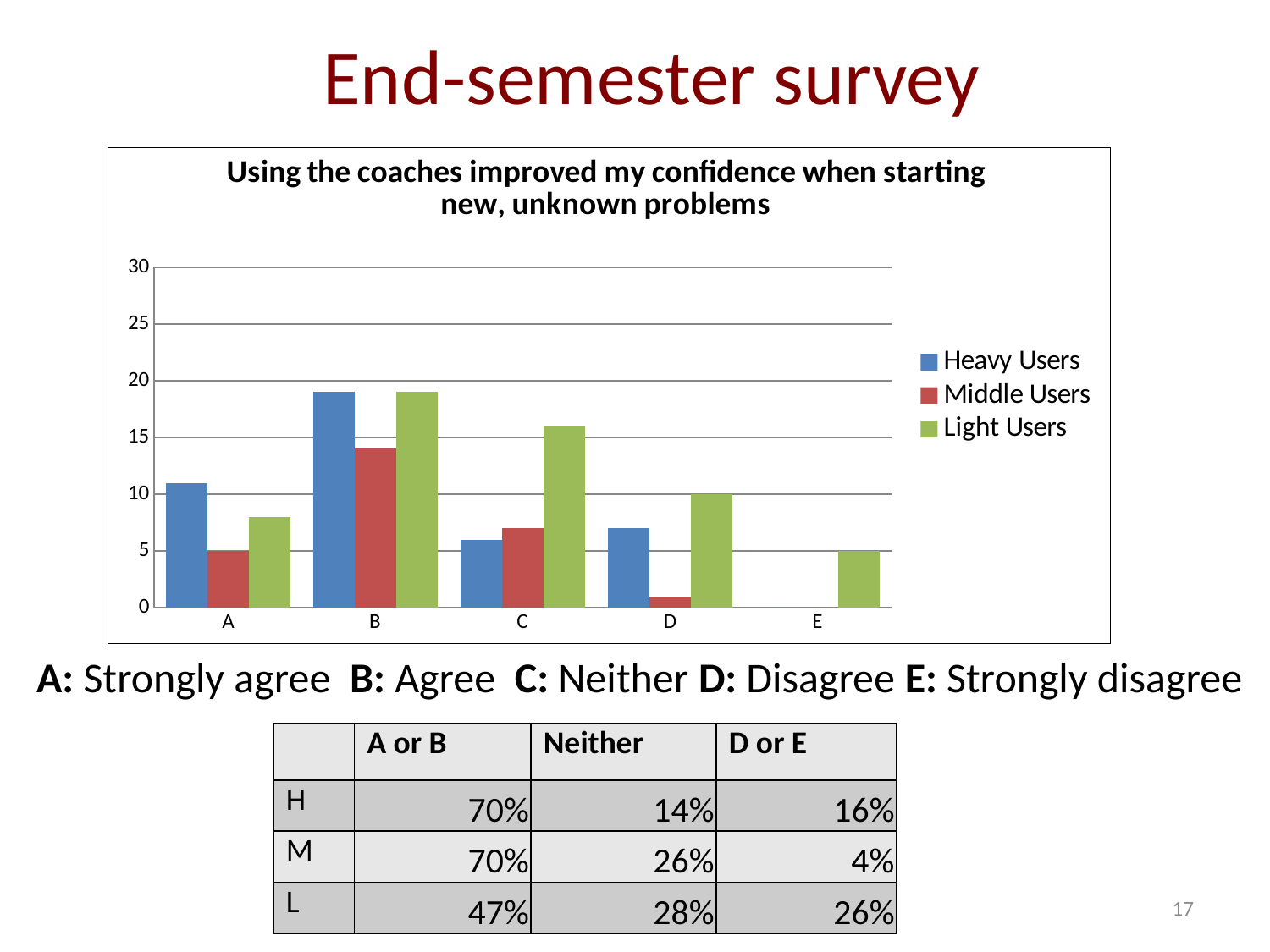
At category C, which is larger: Heavy Users or Light Users? Light Users For Light Users, which category has the lowest value? E For Heavy Users, which category has the highest value? B What is the value for Light Users at category D? 10 At category A, which is larger: Heavy Users or Middle Users? Heavy Users What kind of chart is shown on the slide? bar chart How many categories are shown on the x axis of the chart? 5 What is the title of the chart? Using the coaches improved my confidence when starting new, unknown problems What is the value for Light Users at category E? 5 What is the value for Middle Users at category A? 5 Is the value for Heavy Users at category B greater or less than 15? greater How many series does the chart's legend list? 3